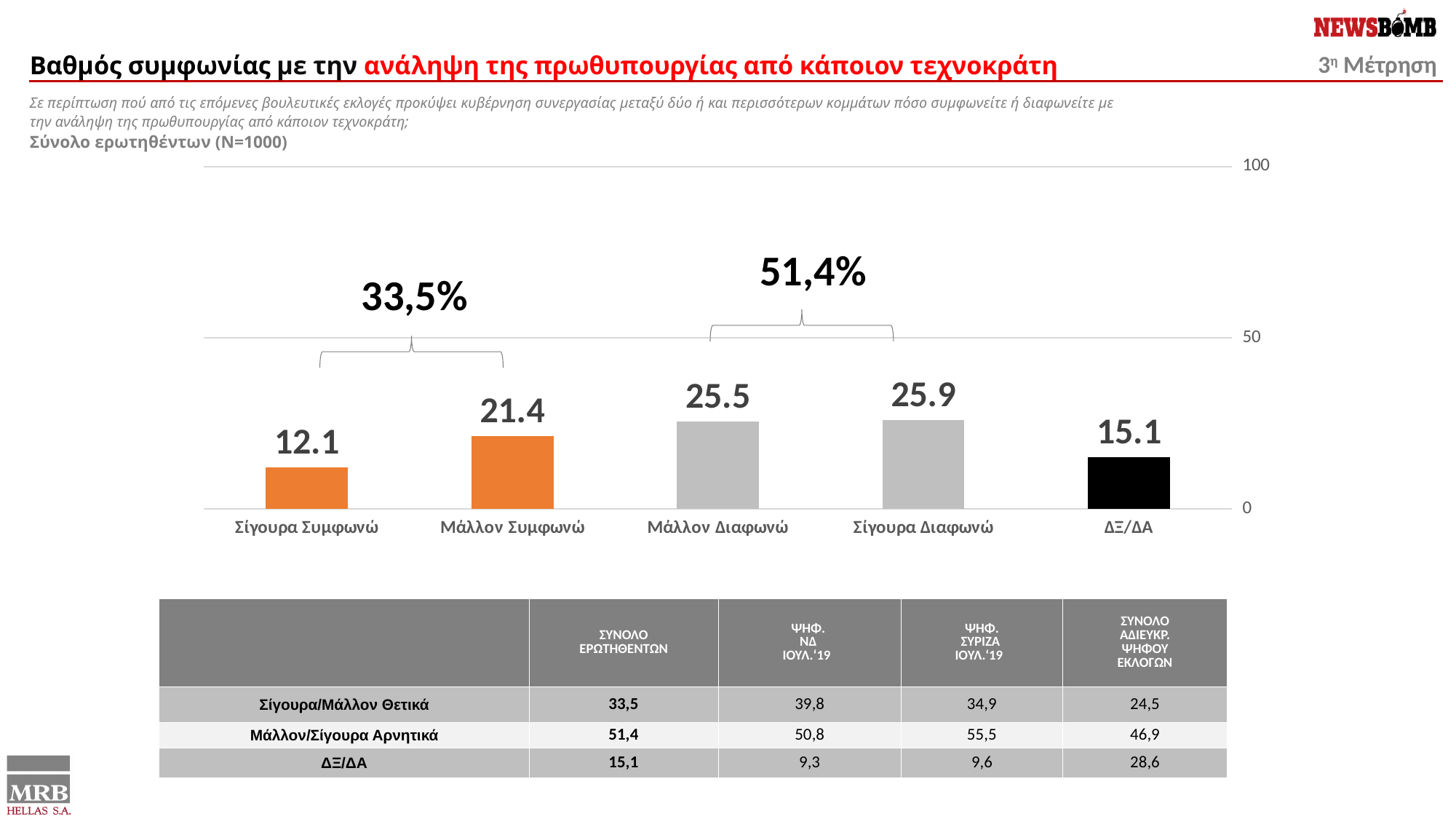
Is the value for Σίγουρα Διαφωνώ greater or less than 50? less What is the value for Μάλλον Συμφωνώ? 21.4 What is the value for Σίγουρα Συμφωνώ? 12.1 How many categories are shown on the x axis of the chart? 5 Which is larger, the value for Μάλλον Διαφωνώ or the value for ΔΞ/ΔΑ? Μάλλον Διαφωνώ What kind of chart is shown on the slide? bar chart What combined percentage is shown above the bracket grouping Μάλλον Διαφωνώ and Σίγουρα Διαφωνώ? 51,4% What is the difference between the values for Μάλλον Συμφωνώ and Σίγουρα Συμφωνώ? 9.3 Which category has the lowest value? Σίγουρα Συμφωνώ What is the value for ΔΞ/ΔΑ? 15.1 Which category has the highest value? Σίγουρα Διαφωνώ What is the value for Σίγουρα Διαφωνώ? 25.9